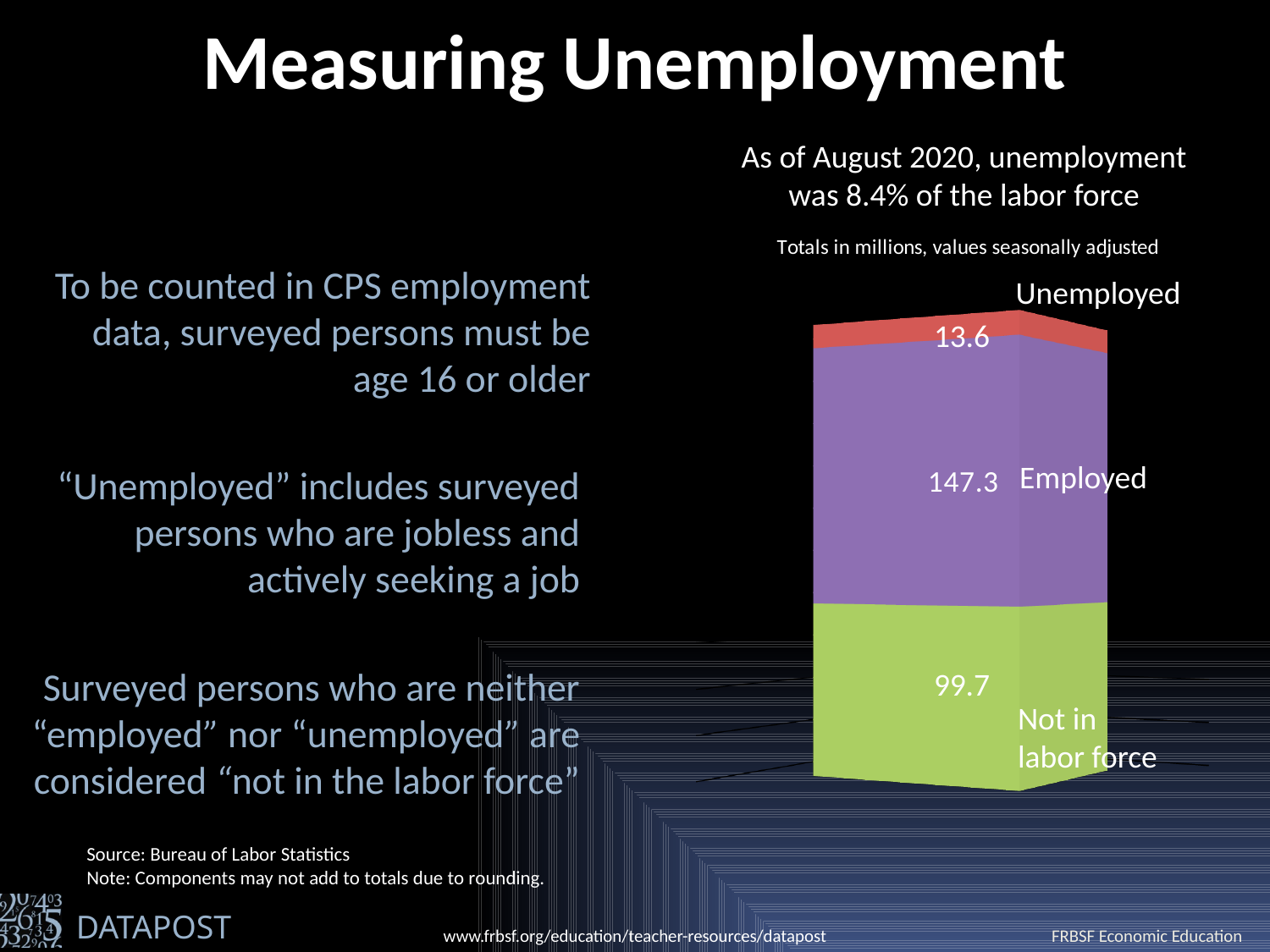
What is the value for Not in labor force? 99.7 What is the value for Unemployed? 13.6 What is the difference between the Employed and Not in labor force values? 47.6 Which segment of the stacked bar has the smallest value? Unemployed What is the total of the stacked bar? 260.6 How many segments make up the stacked bar? 3 What kind of chart is shown on the slide? Stacked bar chart Which is larger, the Employed value or the Not in labor force value? Employed Which segment of the stacked bar has the largest value? Employed What is the value for Employed? 147.3 What is the difference between the Not in labor force and Unemployed values? 86.1 What unit are the chart values given in, according to the chart subtitle? Millions